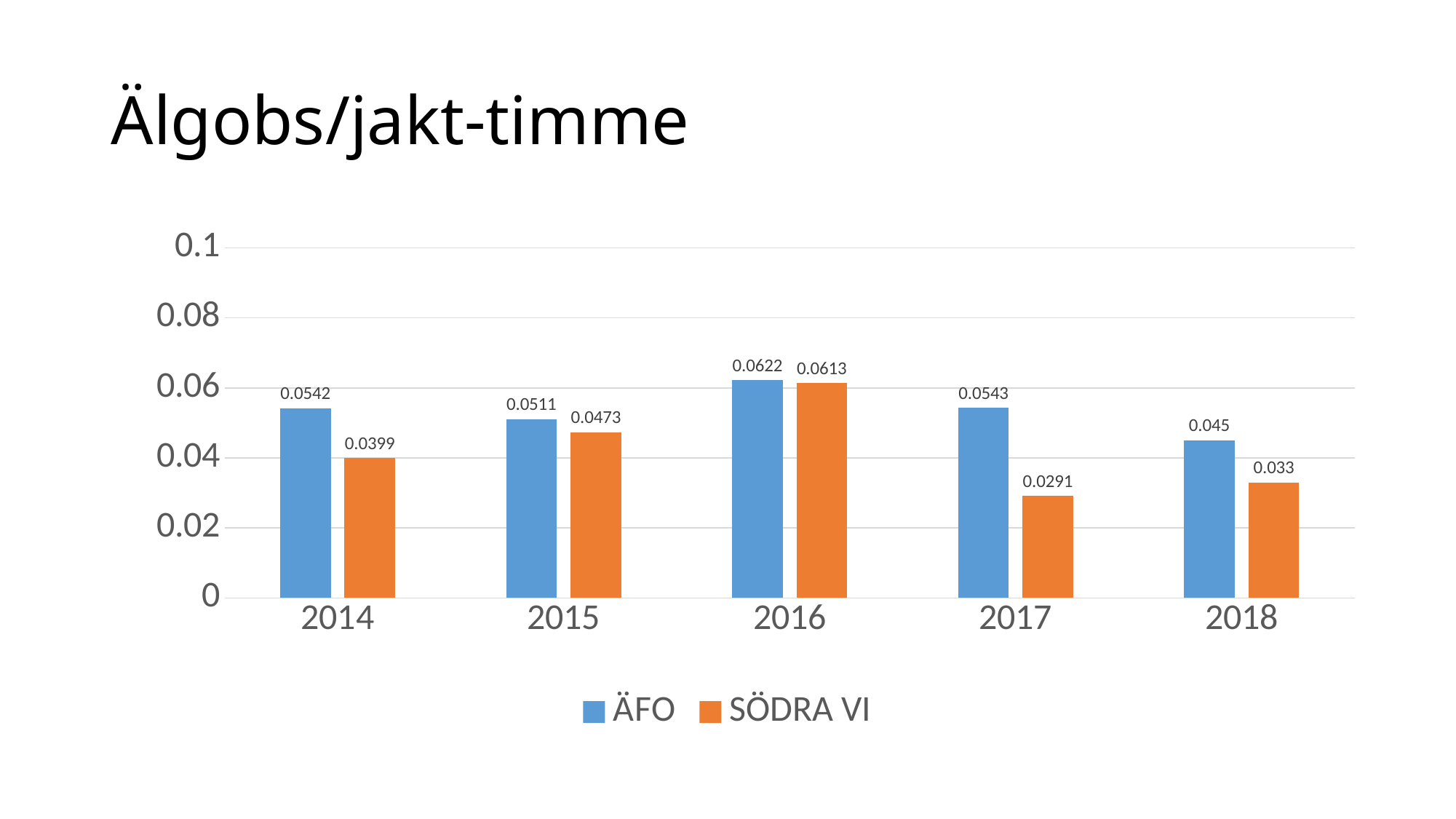
In which year is the SÖDRA VI value lowest? 2017 How many years are shown on the x axis? 5 What kind of chart is shown on the slide? Bar chart What is the ÄFO value for 2016? 0.0622 What is the SÖDRA VI value for 2017? 0.0291 Is the ÄFO value for 2018 greater or less than 0.04? greater How many series does the legend list? 2 What is the difference between the ÄFO and SÖDRA VI values in 2017? 0.0252 What is the SÖDRA VI value for 2014? 0.0399 Which is larger in 2015, the ÄFO value or the SÖDRA VI value? ÄFO In which year is the ÄFO value highest? 2016 Does the SÖDRA VI value rise or fall from 2016 to 2017? Fall